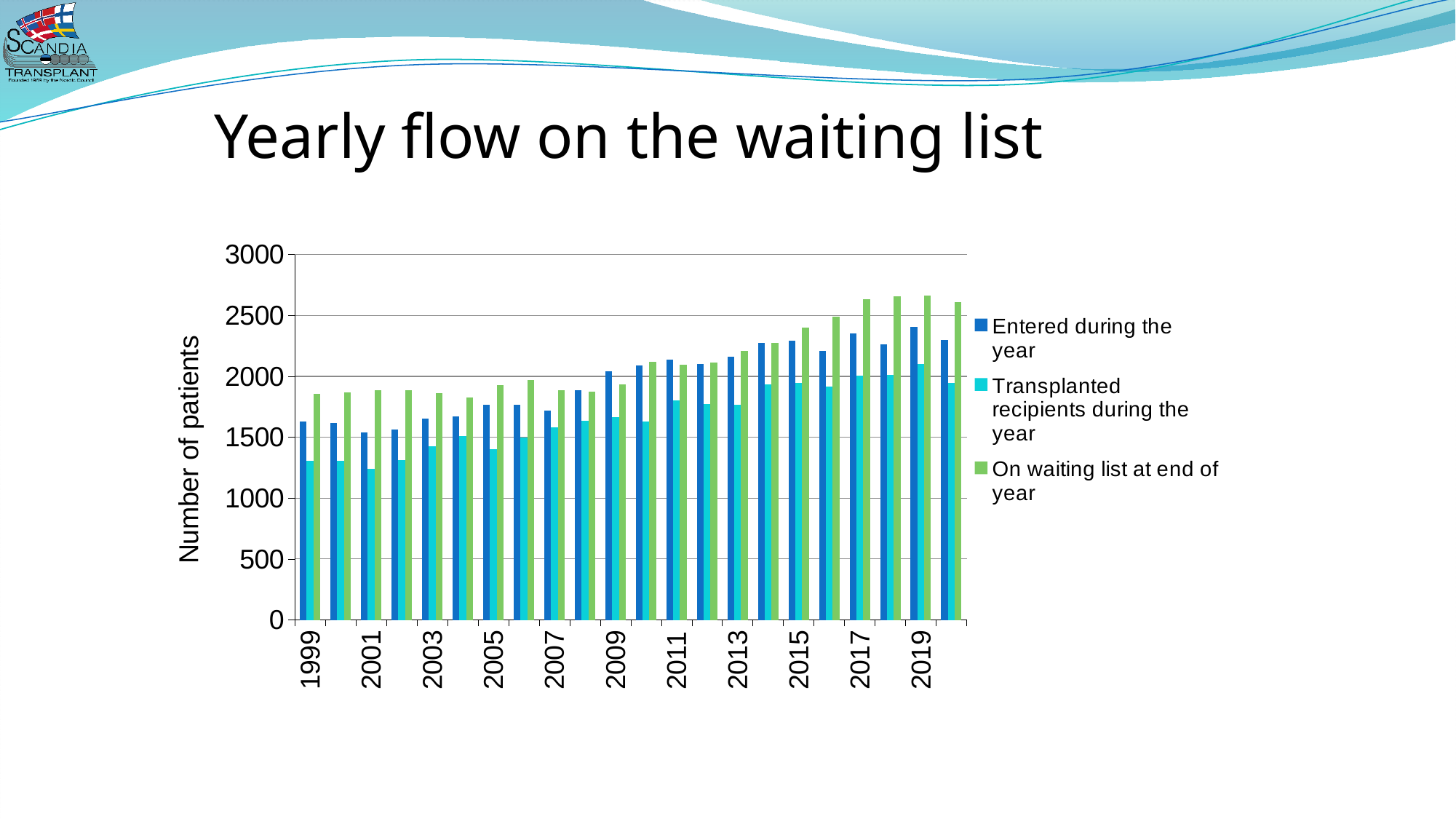
Is the value for 'On waiting list at end of year' in 2019 greater or less than 2500? greater In 2019, which is larger: 'Entered during the year' or 'Transplanted recipients during the year'? Entered during the year How many series does the legend list? 3 What is the title of the slide containing the chart? Yearly flow on the waiting list What is the y-axis title of the chart? Number of patients Is the value for 'Transplanted recipients during the year' in 2001 greater or less than 1500? less What type of chart is shown on the slide? bar chart Does the 'On waiting list at end of year' series generally rise or fall from 1999 to 2019? rise Is the value for 'On waiting list at end of year' in 1999 greater or less than 2000? less How many years are plotted on the x axis of the chart? 22 In which year is 'Transplanted recipients during the year' lowest? 2001